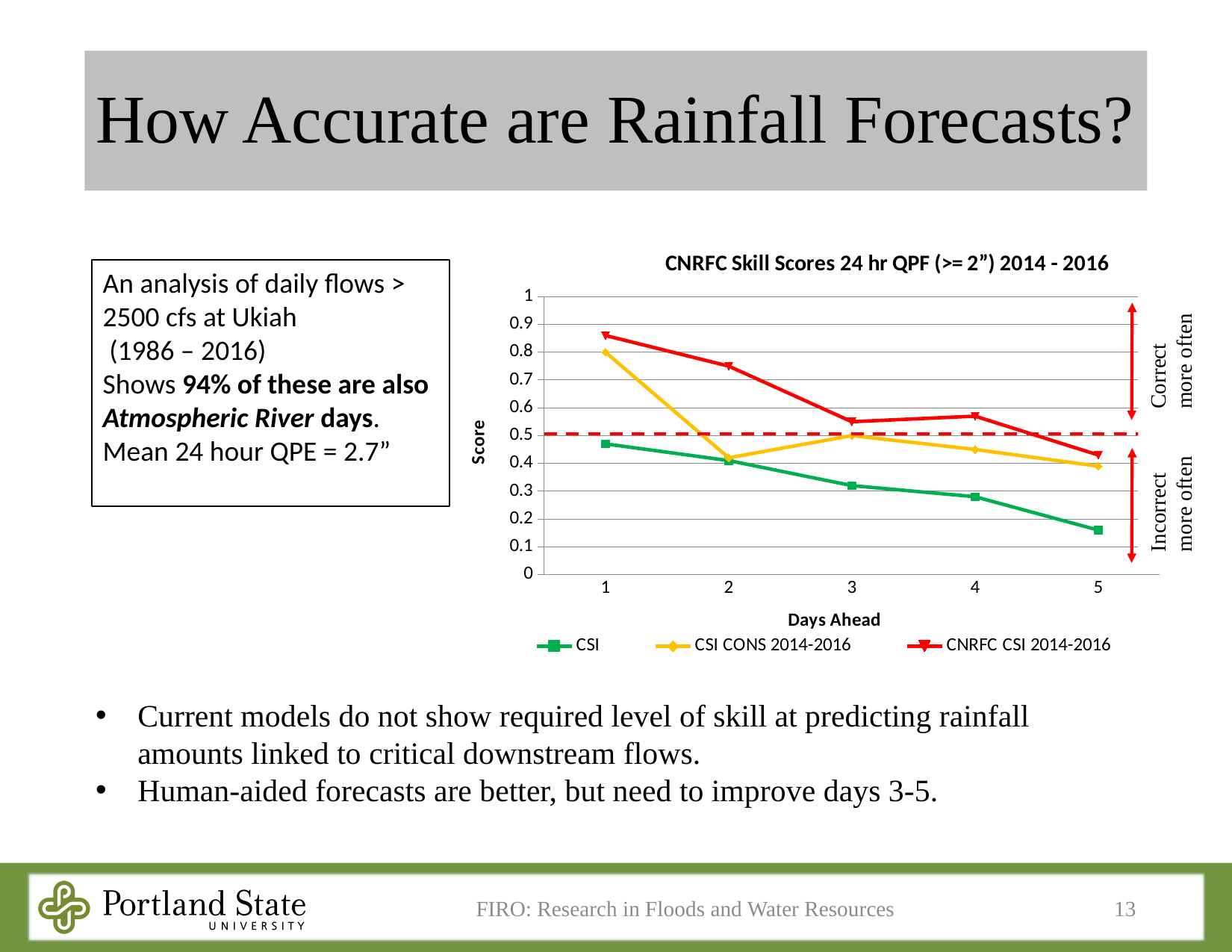
Is the CSI score at 5 days ahead greater or less than 0.2? less How many series does the chart legend list? 3 How many Days Ahead values are plotted along the x axis? 5 Is the CSI score at 1 day ahead greater or less than 0.5? less Is the CSI CONS 2014-2016 score at 1 day ahead greater or less than 0.7? greater What kind of chart is shown on the slide? Line chart What is the title of the chart? CNRFC Skill Scores 24 hr QPF (>= 2") 2014 - 2016 At 1 day ahead, which series has the larger score: CSI or CNRFC CSI 2014-2016? CNRFC CSI 2014-2016 At which Days Ahead value is the CNRFC CSI 2014-2016 score highest? 1 At 3 days ahead, which series has the larger score: CSI or CSI CONS 2014-2016? CSI CONS 2014-2016 Does the CSI series rise or fall as Days Ahead increases from 1 to 5? Fall